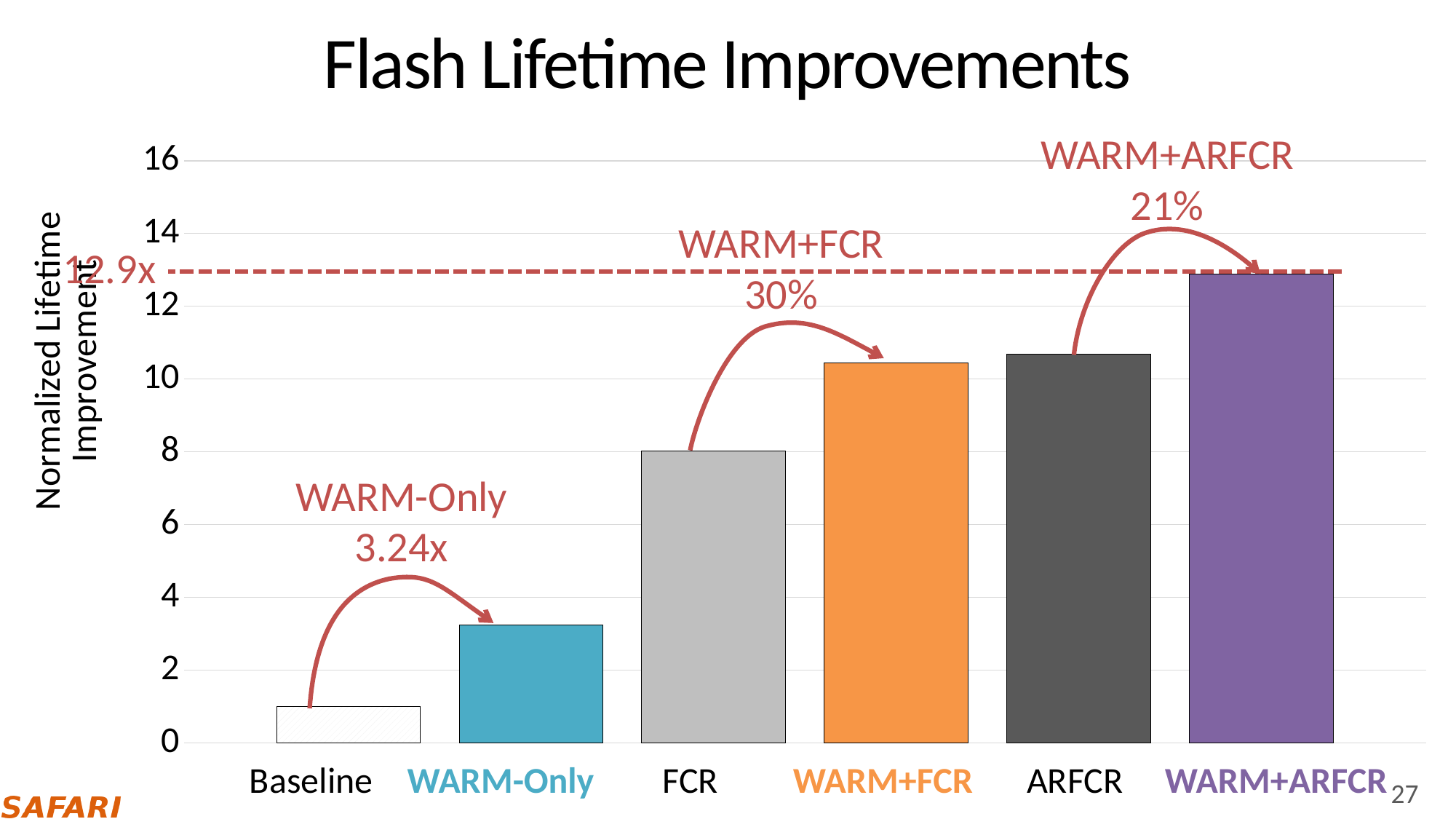
Which category has the highest normalized lifetime improvement? WARM+ARFCR What percentage improvement is annotated from ARFCR to WARM+ARFCR? 21% What lifetime improvement is annotated for WARM-Only? 3.24x Which category has the lowest normalized lifetime improvement? Baseline What value does the dashed line at the top of the WARM+ARFCR bar mark? 12.9x Is the value for Baseline greater or less than 2? less What kind of chart is shown on the slide? bar chart How many categories are plotted on the x axis? 6 What is the title of the chart? Flash Lifetime Improvements Which is larger, the value for FCR or the value for WARM+FCR? WARM+FCR Is the value for WARM+FCR greater or less than 10? greater What percentage improvement is annotated from FCR to WARM+FCR? 30%